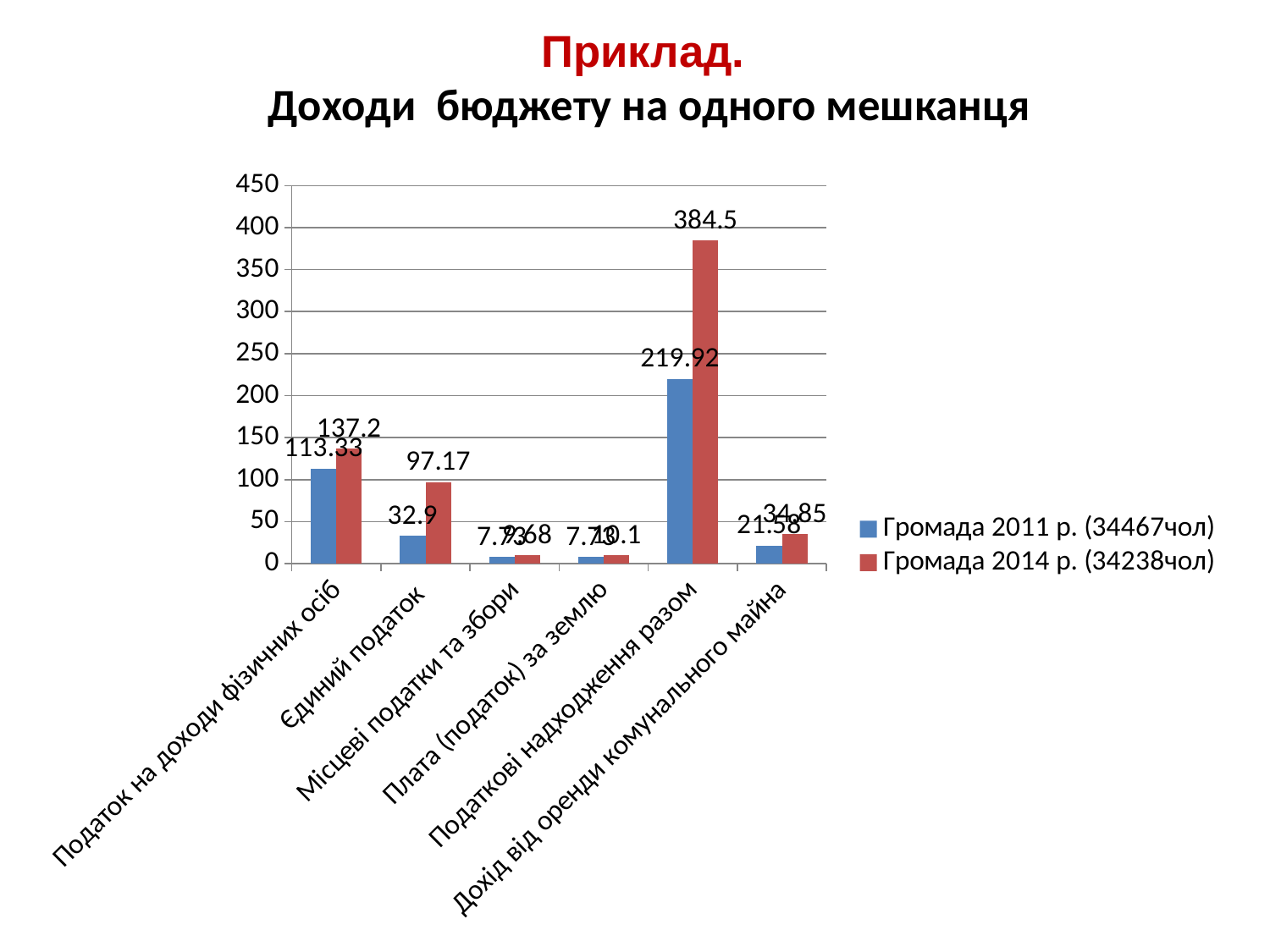
How many series does the legend list? 2 What is the value for Податкові надходження разом for Громада 2011 р. (34467чол)? 219.92 What is the value for Податкові надходження разом for Громада 2014 р. (34238чол)? 384.5 What is the value for Дохід від оренди комунального майна for Громада 2011 р. (34467чол)? 21.58 How many categories are shown on the x axis? 6 Which category has the highest value for Громада 2014 р. (34238чол)? Податкові надходження разом For Єдиний податок, which series has the larger value: Громада 2011 р. (34467чол) or Громада 2014 р. (34238чол)? Громада 2014 р. (34238чол) What is the value for Єдиний податок for Громада 2014 р. (34238чол)? 97.17 Is the value for Податок на доходи фізичних осіб for Громада 2014 р. (34238чол) greater or less than 100? greater What is the value for Податок на доходи фізичних осіб for Громада 2011 р. (34467чол)? 113.33 What is the difference between the Громада 2014 р. and Громада 2011 р. values for Податкові надходження разом? 164.58 What kind of chart is shown on the slide? bar chart